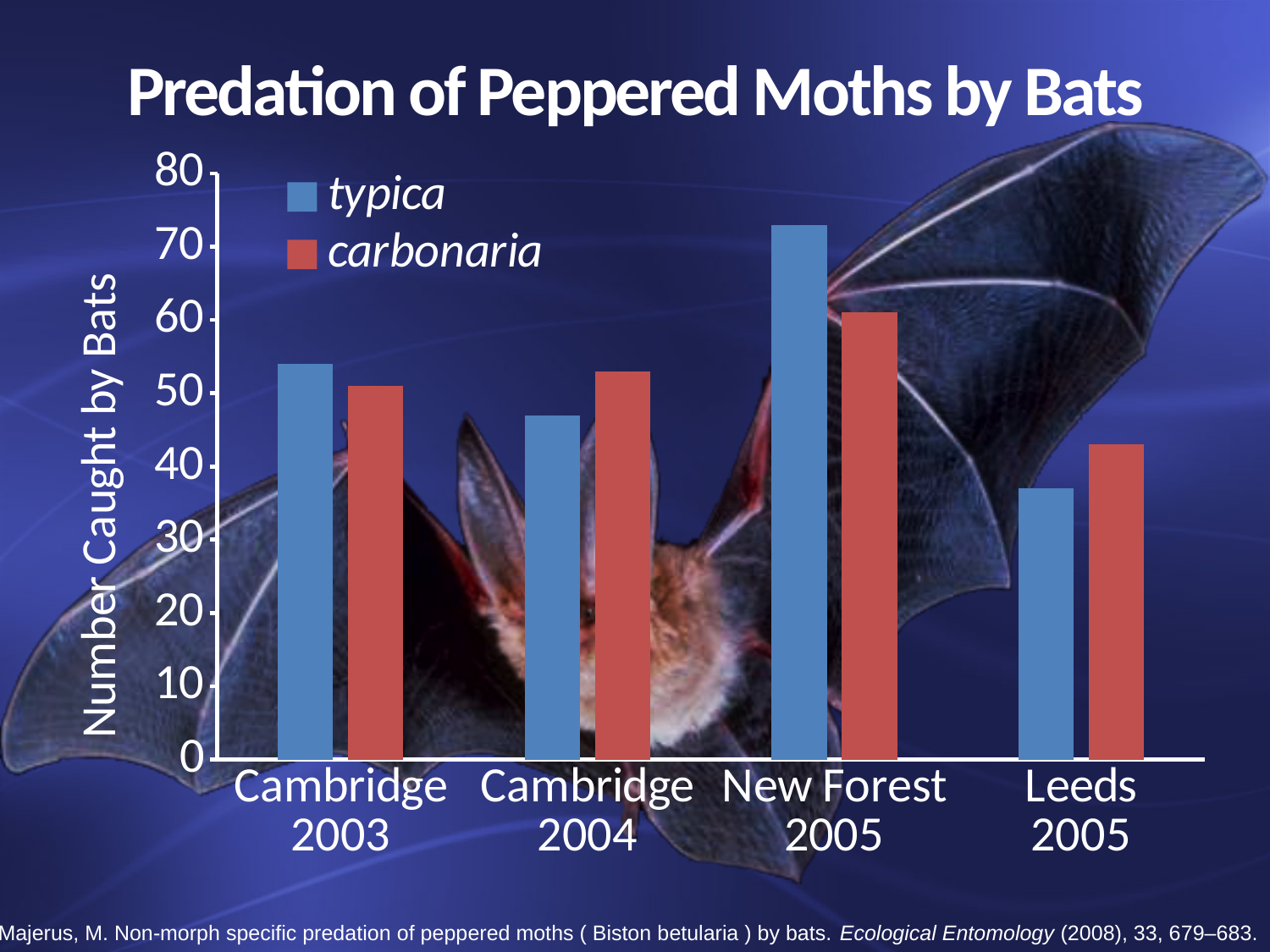
For which category is the typica value highest? New Forest 2005 Is the typica value for New Forest 2005 greater or less than 70? greater How many series does the legend list? 2 For which category is the typica value lowest? Leeds 2005 For which category is the carbonaria value highest? New Forest 2005 Is the typica value for Leeds 2005 greater or less than 40? less For which category is the carbonaria value lowest? Leeds 2005 At New Forest 2005, which series has the larger value, typica or carbonaria? typica At Leeds 2005, which series has the larger value, typica or carbonaria? carbonaria How many location/year categories are shown on the x axis? 4 What kind of chart is shown on the slide? bar chart What is the label on the y axis of the chart? Number Caught by Bats